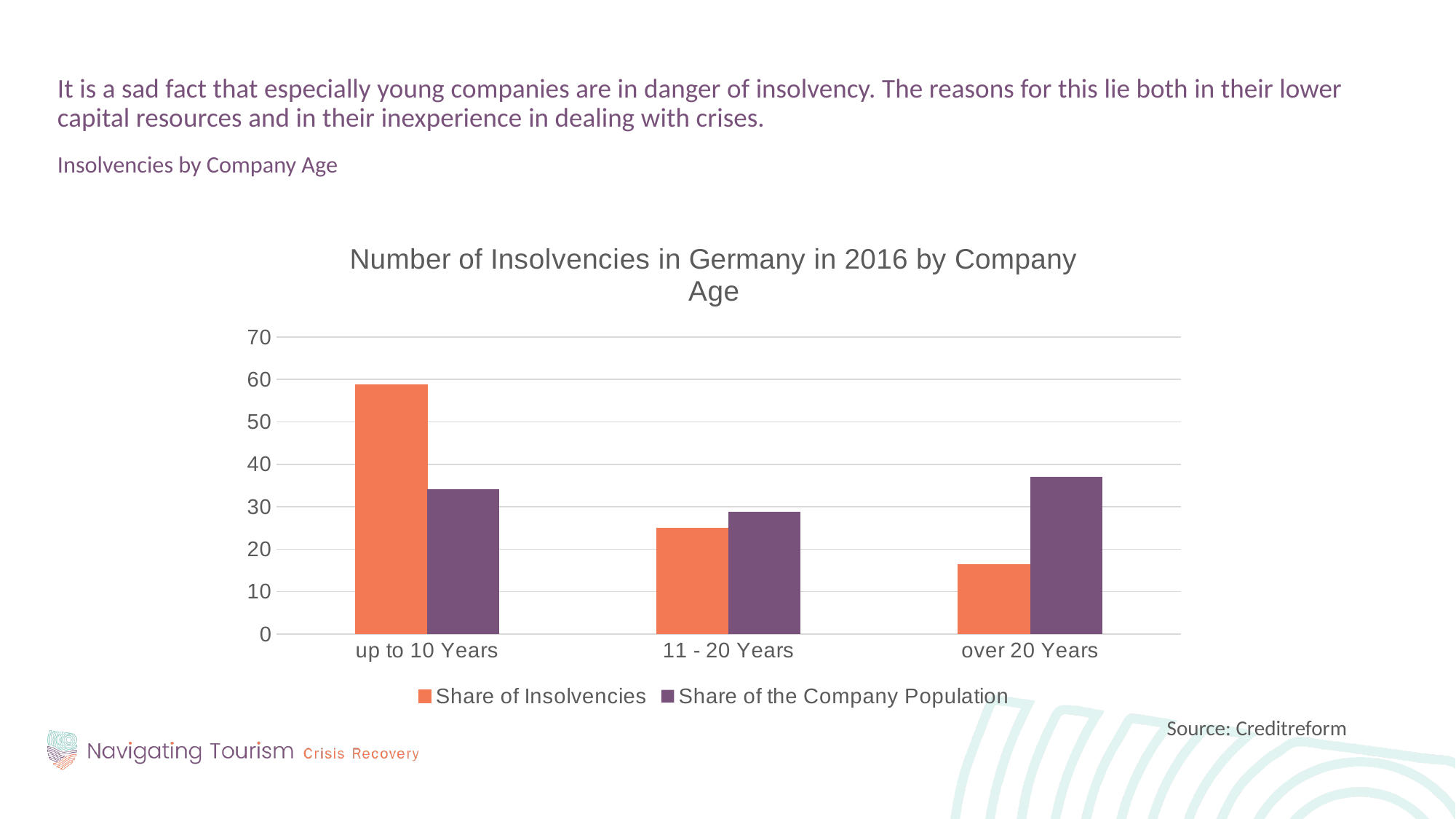
Which company age category has the lowest Share of Insolvencies? over 20 Years What is the title of the chart? Number of Insolvencies in Germany in 2016 by Company Age How many company age categories are shown on the x axis? 3 Is the Share of Insolvencies for up to 10 Years greater or less than 50? greater Which company age category has the highest Share of the Company Population? over 20 Years Is the Share of the Company Population for over 20 Years greater or less than 30? greater What kind of chart is shown on the slide? bar chart How many series does the chart legend list? 2 Which company age category has the highest Share of Insolvencies? up to 10 Years Is the Share of Insolvencies for over 20 Years greater or less than 20? less For up to 10 Years, which is larger: Share of Insolvencies or Share of the Company Population? Share of Insolvencies Does the Share of Insolvencies rise or fall as company age increases along the x axis? fall